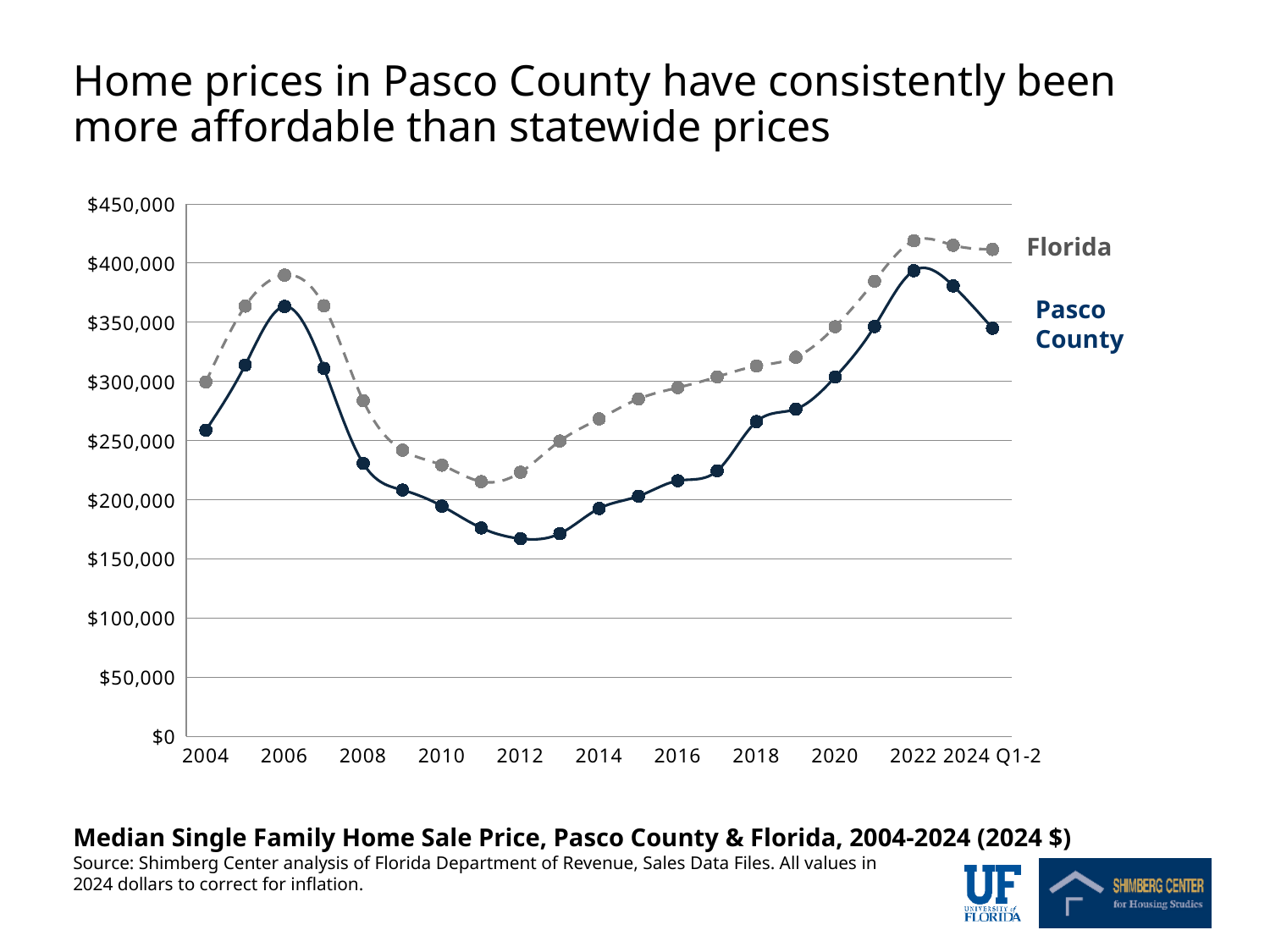
Which series is drawn with a dashed gray line? Florida What is the title of the chart? Median Single Family Home Sale Price, Pasco County & Florida, 2004-2024 (2024 $) Is the Pasco County value for 2022 greater or less than $400,000? less Is the Florida value for 2006 greater or less than $400,000? less Is the Pasco County value for 2012 greater or less than $150,000? greater In which year does the Pasco County series reach its highest value? 2022 Does the Pasco County series rise or fall between 2006 and 2012? Fall In which year does the Florida series reach its highest value? 2022 In 2010, which series has the higher value, Florida or Pasco County? Florida How many series does the chart show? 2 What kind of chart is shown on the slide? Line chart